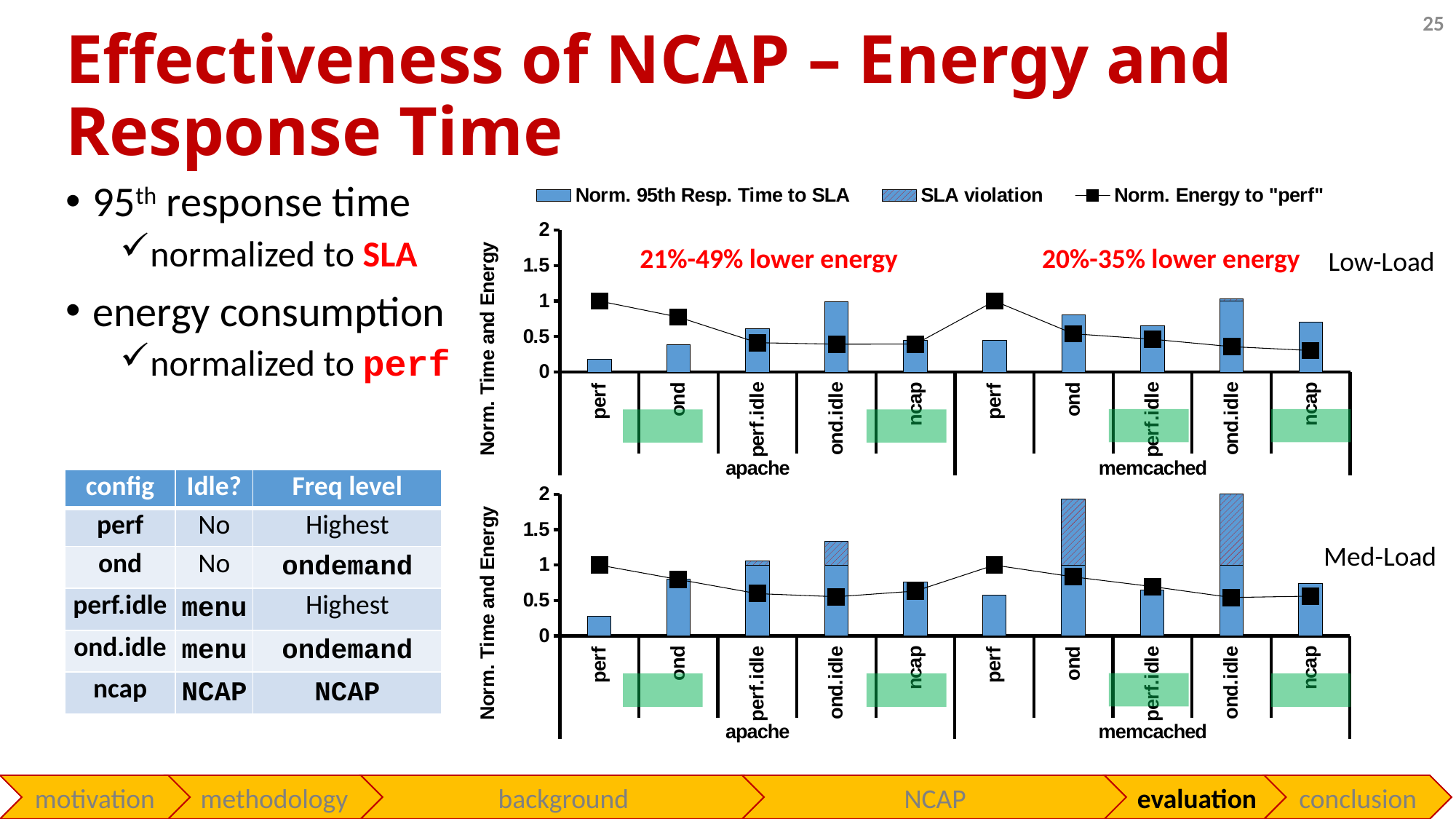
What red annotation is printed above the apache group in the Low-Load chart? 21%-49% lower energy In the Low-Load chart, which configuration has the lowest Norm. 95th Resp. Time to SLA bar? apache perf In the Low-Load chart, which has the higher Norm. Energy to "perf" value: apache perf or apache ncap? apache perf In the Low-Load chart, what is the Norm. Energy to "perf" value for the apache perf configuration? 1 What kind of chart is the Low-Load chart? Bar chart with a line series How many configuration categories are plotted along the x axis of the Med-Load chart? 10 In the Med-Load chart, is the total bar height (including SLA violation) for memcached ond greater or less than 1.5? greater In the Low-Load chart, is the Norm. 95th Resp. Time to SLA for apache perf greater or less than 0.5? less In the Med-Load chart, is the total bar height for apache ond.idle greater or less than 1? greater In the Low-Load chart, does the Norm. Energy to "perf" line rise or fall from apache perf to apache perf.idle? fall How many series does the legend list for the charts? 3 In the Low-Load chart, which has the larger Norm. 95th Resp. Time to SLA bar: apache perf or apache ond? apache ond